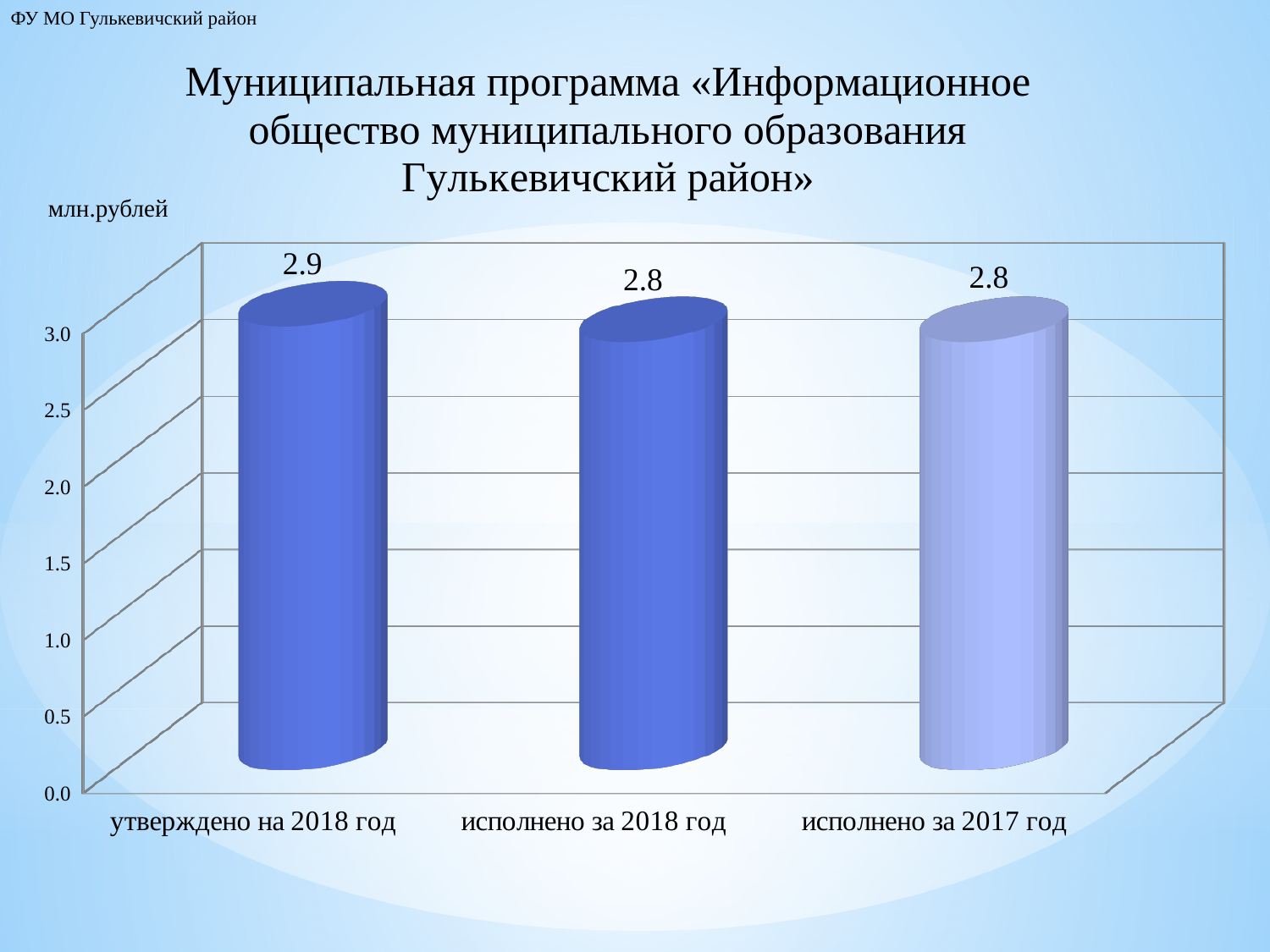
Is the value for «исполнено за 2017 год» greater or less than 2.5? greater Is the value for «утверждено на 2018 год» greater or less than 3.0? less What is the value for «исполнено за 2018 год»? 2.8 What is the value for «утверждено на 2018 год»? 2.9 Which category has the highest value? утверждено на 2018 год What kind of chart is shown on the slide? bar chart What is the title of the chart? Муниципальная программа «Информационное общество муниципального образования Гулькевичский район» What is the value for «исполнено за 2017 год»? 2.8 What is the difference between the value for «утверждено на 2018 год» and the value for «исполнено за 2018 год»? 0.1 How many categories are shown on the chart? 3 Which is larger: the value for «утверждено на 2018 год» or the value for «исполнено за 2018 год»? утверждено на 2018 год What unit of measurement is indicated above the chart? млн.рублей